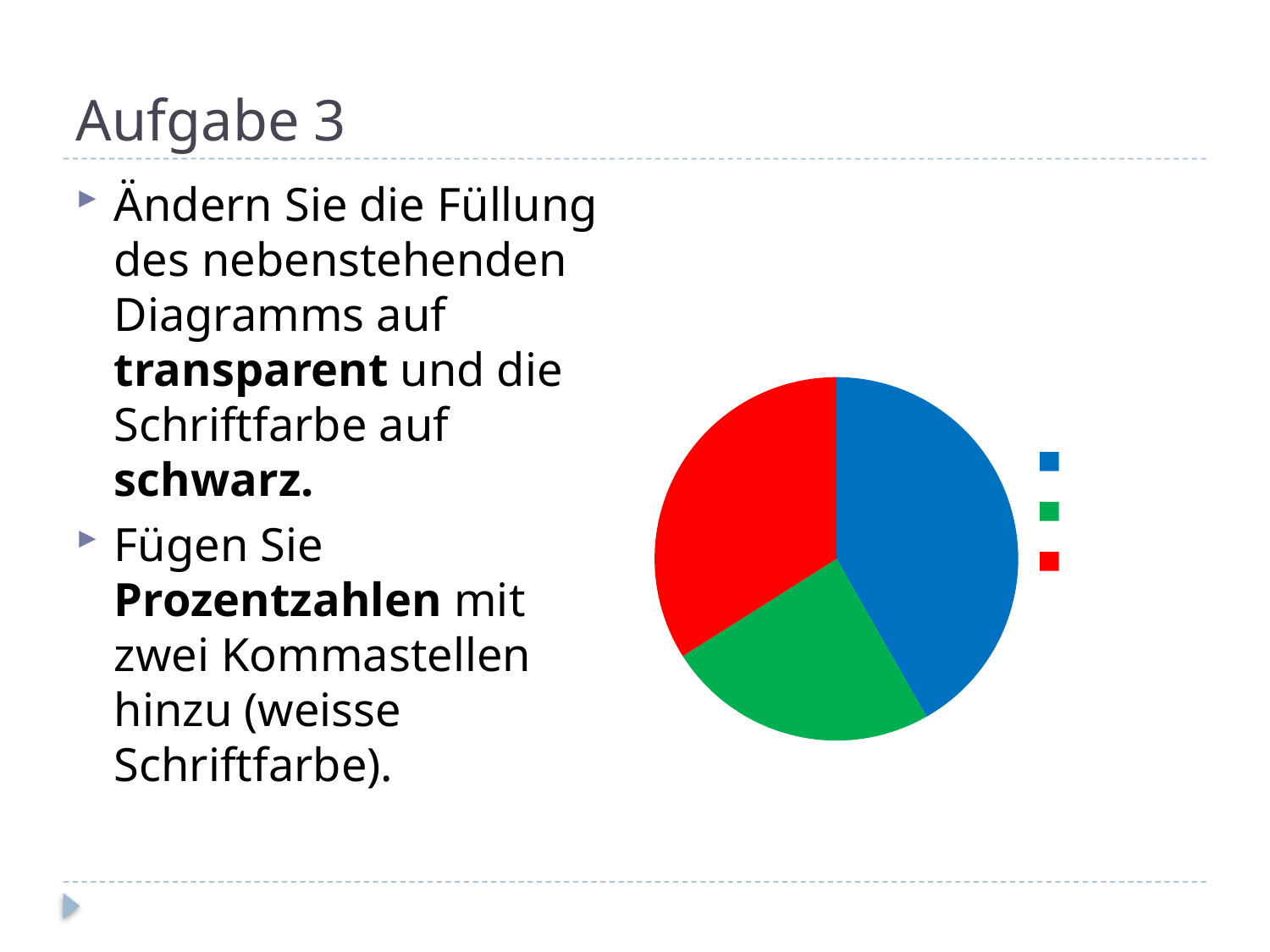
What colours are used for the slices of the pie chart? blue, green and red How many entries does the legend of the pie chart list? 3 Which slice of the pie chart is the largest? the blue slice Which is larger in the pie chart, the red slice or the green slice? the red slice Does the pie chart show any data labels or percentage values on its slices? No Which slice of the pie chart is the smallest? the green slice What kind of chart is shown on the slide? pie chart How many slices does the pie chart have? 3 Which is larger in the pie chart, the blue slice or the green slice? the blue slice